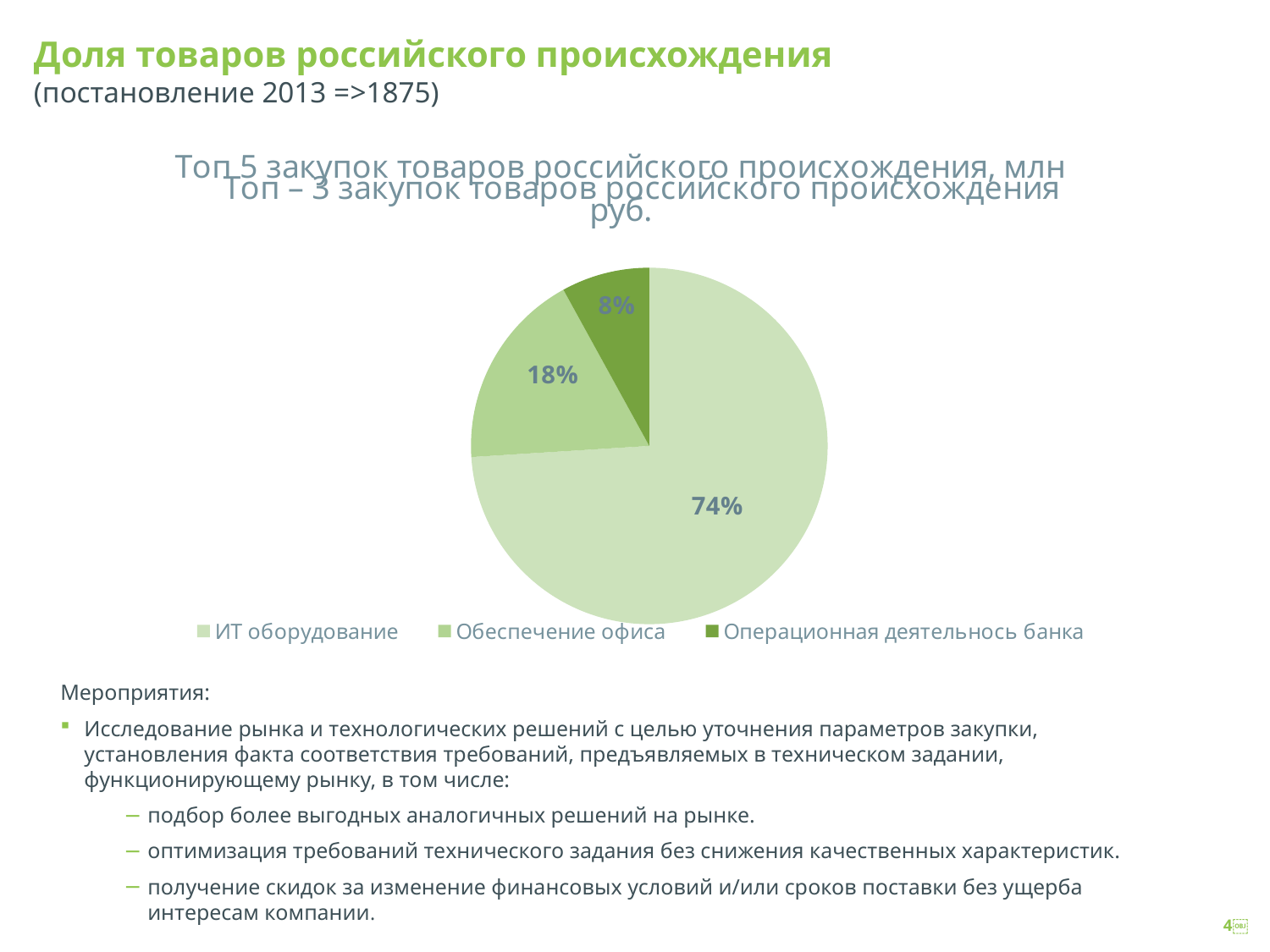
Which category has the largest slice of the pie? ИТ оборудование How many slices does the pie chart have? 3 Which category has the smallest slice of the pie? Операционная деятельнось банка What share of the pie does ИТ оборудование have? 74% What is the difference in percentage points between ИТ оборудование and Обеспечение офиса? 56 What share of the pie does Операционная деятельнось банка have? 8% What share of the pie does Обеспечение офиса have? 18% How many entries does the legend list? 3 What kind of chart is shown on the slide? pie chart Which legend entry is shown in the darkest green? Операционная деятельнось банка Which is larger: the share for Обеспечение офиса or for Операционная деятельнось банка? Обеспечение офиса What is the difference in percentage points between Обеспечение офиса and Операционная деятельнось банка? 10